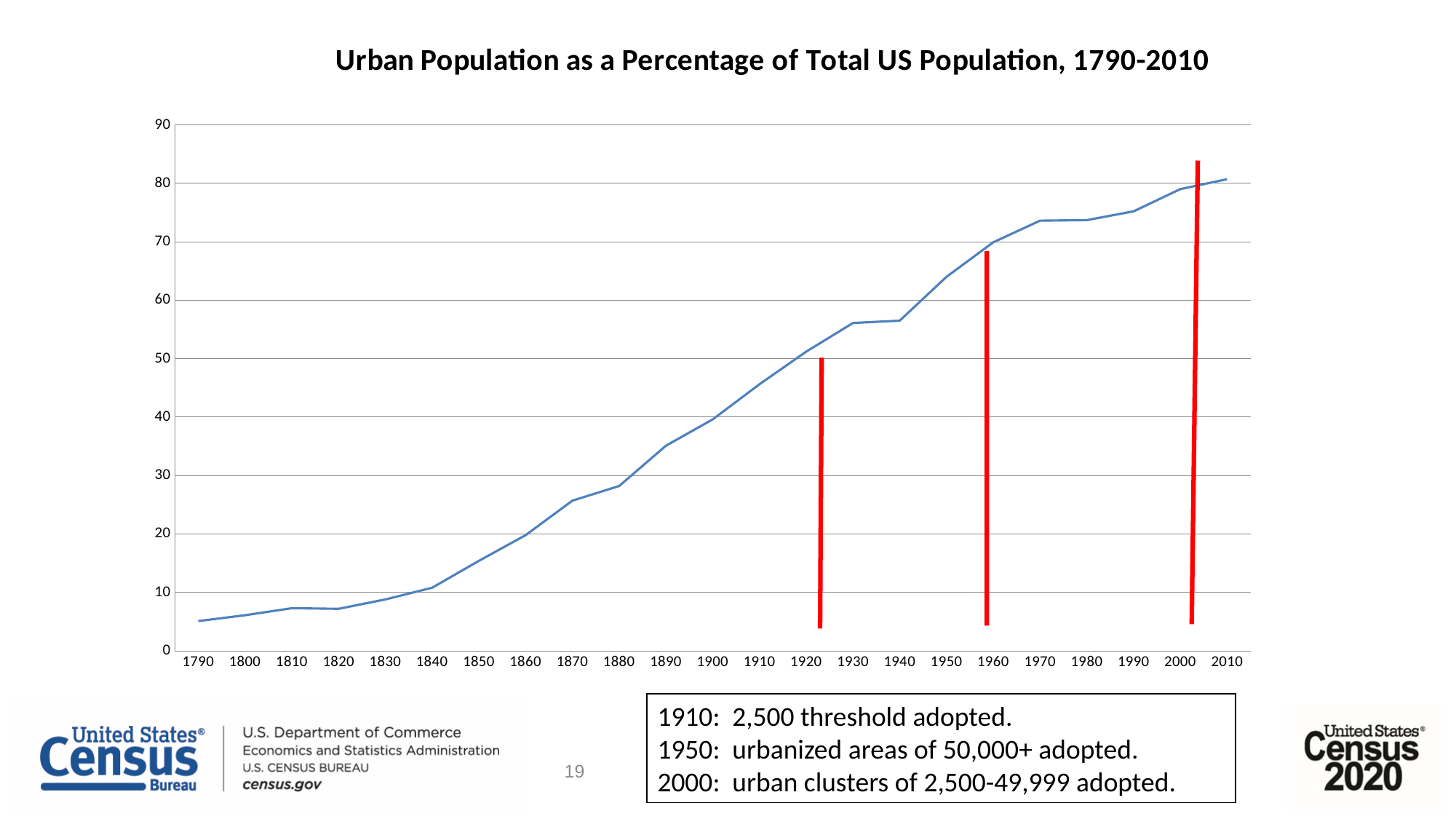
Which year has the lowest urban population percentage? 1790 Which year has the highest urban population percentage? 2010 How many years are labelled along the x axis of the chart? 23 How many red vertical lines are drawn on the chart? 3 Is the value for 1940 greater or less than 50? greater What kind of chart is shown on the slide? Line chart Does the urban population percentage generally rise or fall from 1790 to 2010? Rise Is the value for 1990 greater or less than 80? less What is the title of the chart? Urban Population as a Percentage of Total US Population, 1790-2010 Is the value for 1790 greater or less than 10? less Which year has a larger urban population percentage, 1800 or 1900? 1900